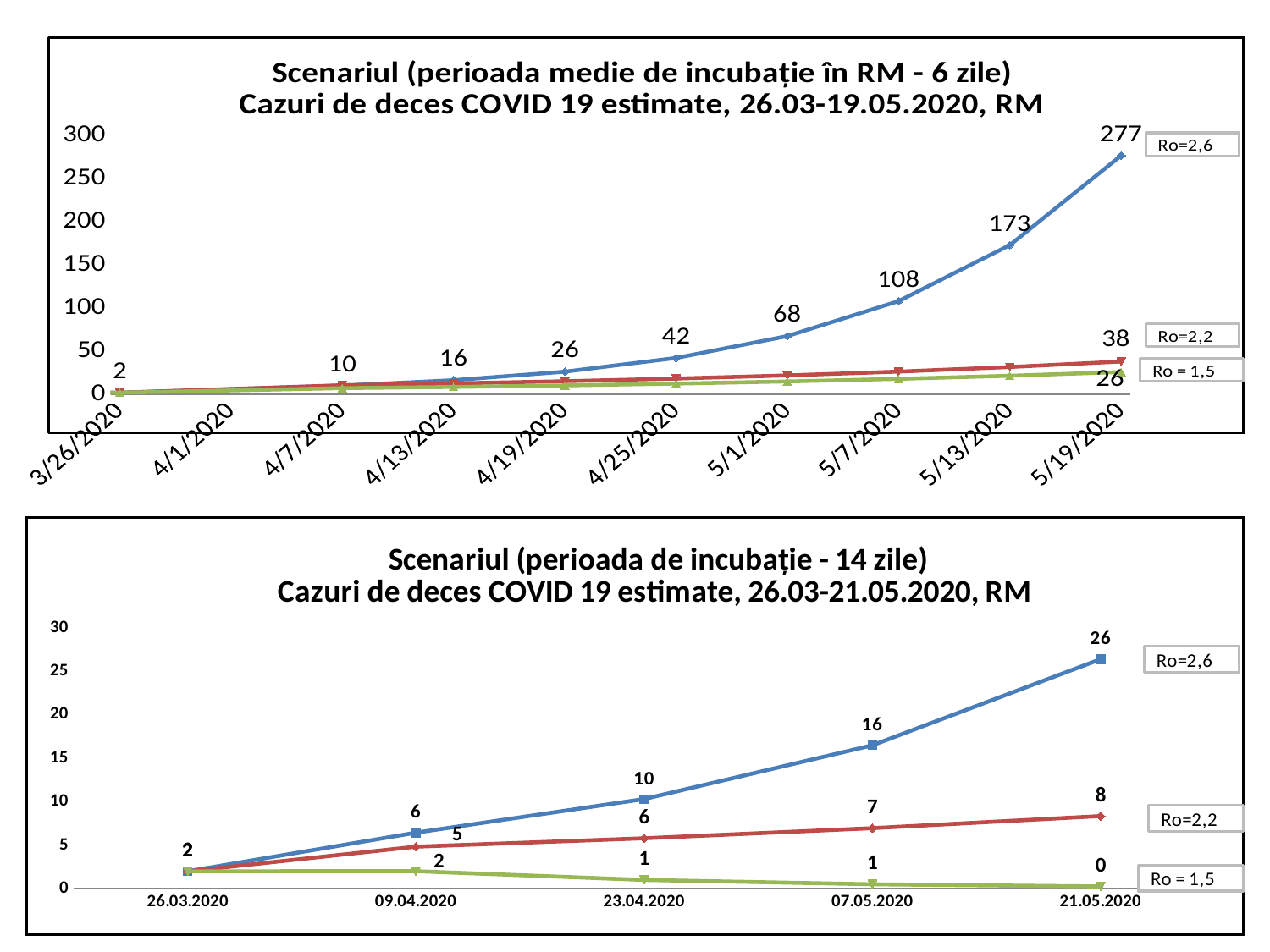
In the bottom chart (14-day incubation scenario), which line has the highest value on 07.05.2020? Ro=2,6 In the bottom chart (14-day incubation scenario), what is the value of the Ro=1,5 line on 21.05.2020? 0 In the bottom chart (14-day incubation scenario), does the Ro=1,5 line rise or fall from 09.04.2020 to 21.05.2020? fall In the top chart (6-day incubation scenario), is the Ro=2,6 value on 5/1/2020 greater or less than 50? greater In the top chart (6-day incubation scenario), what is the value of the Ro=2,6 line on 5/7/2020? 108 In the bottom chart (14-day incubation scenario), what is the difference between the Ro=2,6 and Ro=2,2 values on 21.05.2020? 18 In the top chart (6-day incubation scenario), what is the difference between the Ro=2,6 values on 5/19/2020 and 5/13/2020? 104 In the top chart (6-day incubation scenario), what is the value of the Ro=2,6 line on 5/19/2020? 277 In the top chart (6-day incubation scenario), how many dates are labelled on the x axis? 10 In the bottom chart (14-day incubation scenario), what is the value of the Ro=2,6 line on 21.05.2020? 26 What kind of chart is the top chart (6-day incubation scenario)? line chart In the top chart (6-day incubation scenario), what is the value of the Ro=2,2 line on 5/19/2020? 38